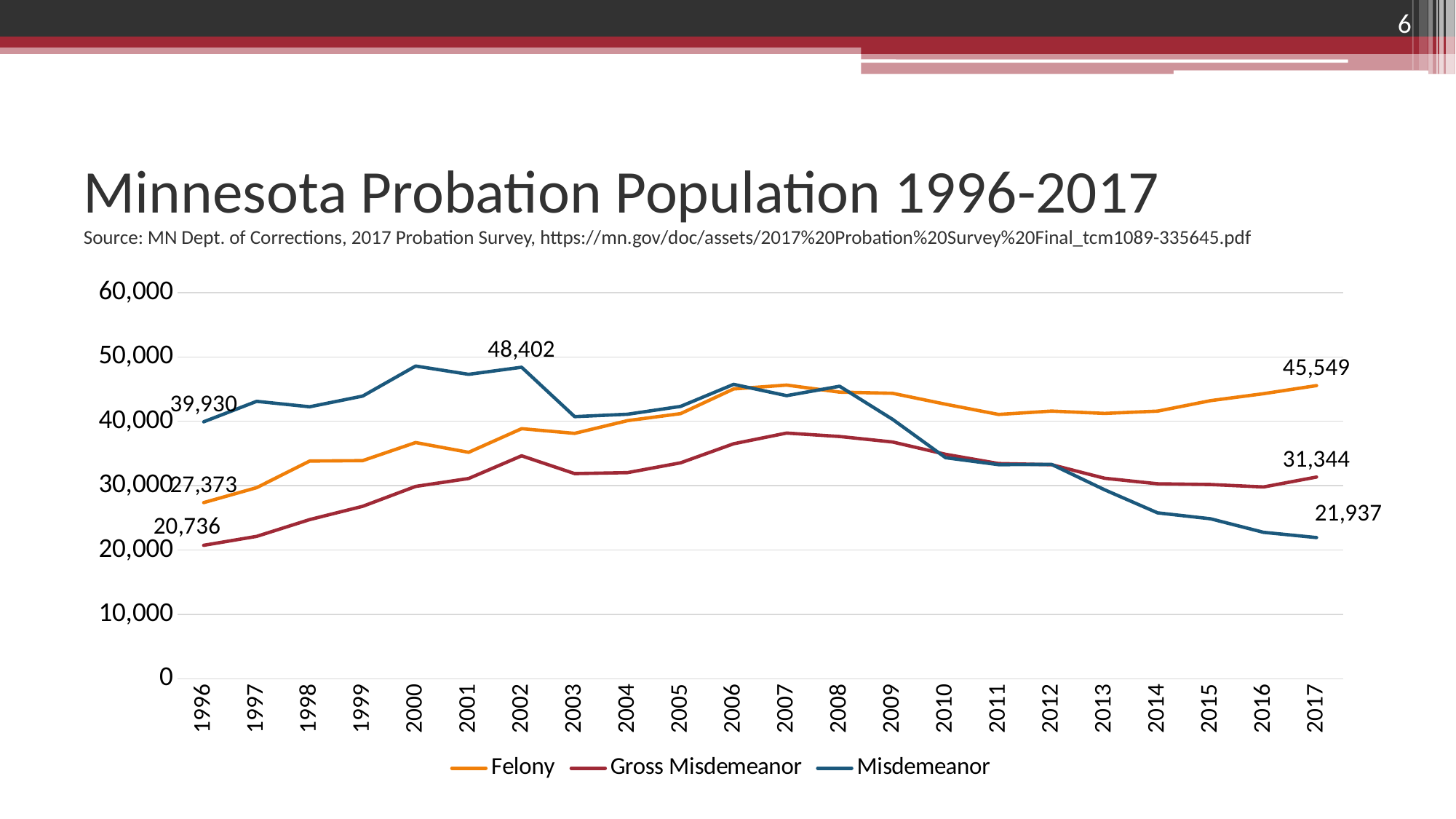
Which series has the higher value in 2017, Felony or Misdemeanor? Felony Is the Gross Misdemeanor value in 2007 greater or less than 30,000? greater How many series does the legend list? 3 What is the difference between the Felony values in 2017 and 1996? 18,176 Does the Misdemeanor series rise or fall from 2008 to 2017? fall How many years are shown on the x axis? 22 What is the Misdemeanor probation population in 1996? 39,930 What is the Gross Misdemeanor probation population in 2017? 31,344 What is the difference between the Misdemeanor values in 1996 and 2017? 17,993 What kind of chart is shown on the slide? line chart What is the Felony probation population in 2017? 45,549 What is the labelled Misdemeanor value in 2002? 48,402